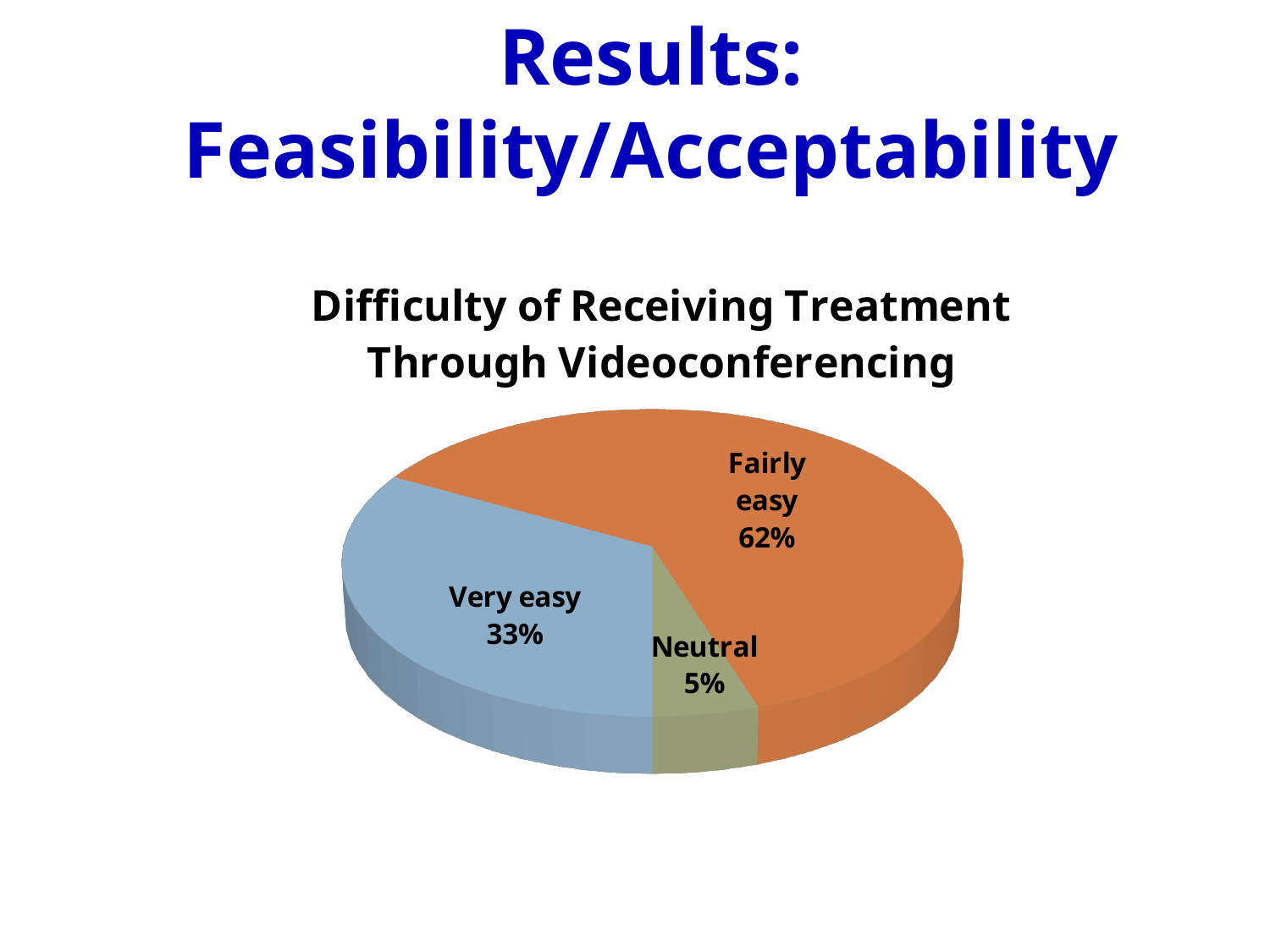
What kind of chart is shown on the slide? pie chart What share of the pie do "Fairly easy" and "Very easy" make up together? 95% Which slice is larger, "Very easy" or "Neutral"? Very easy What colour is the "Very easy" slice? light blue What is the difference in percentage points between the "Fairly easy" and "Very easy" slices? 29 What percentage of the pie is labelled "Fairly easy"? 62% What percentage of the pie is labelled "Very easy"? 33% What percentage of the pie is labelled "Neutral"? 5% What is the title of the chart? Difficulty of Receiving Treatment Through Videoconferencing Which slice of the pie is the largest? Fairly easy How many slices does the pie chart have? 3 Which slice of the pie is the smallest? Neutral